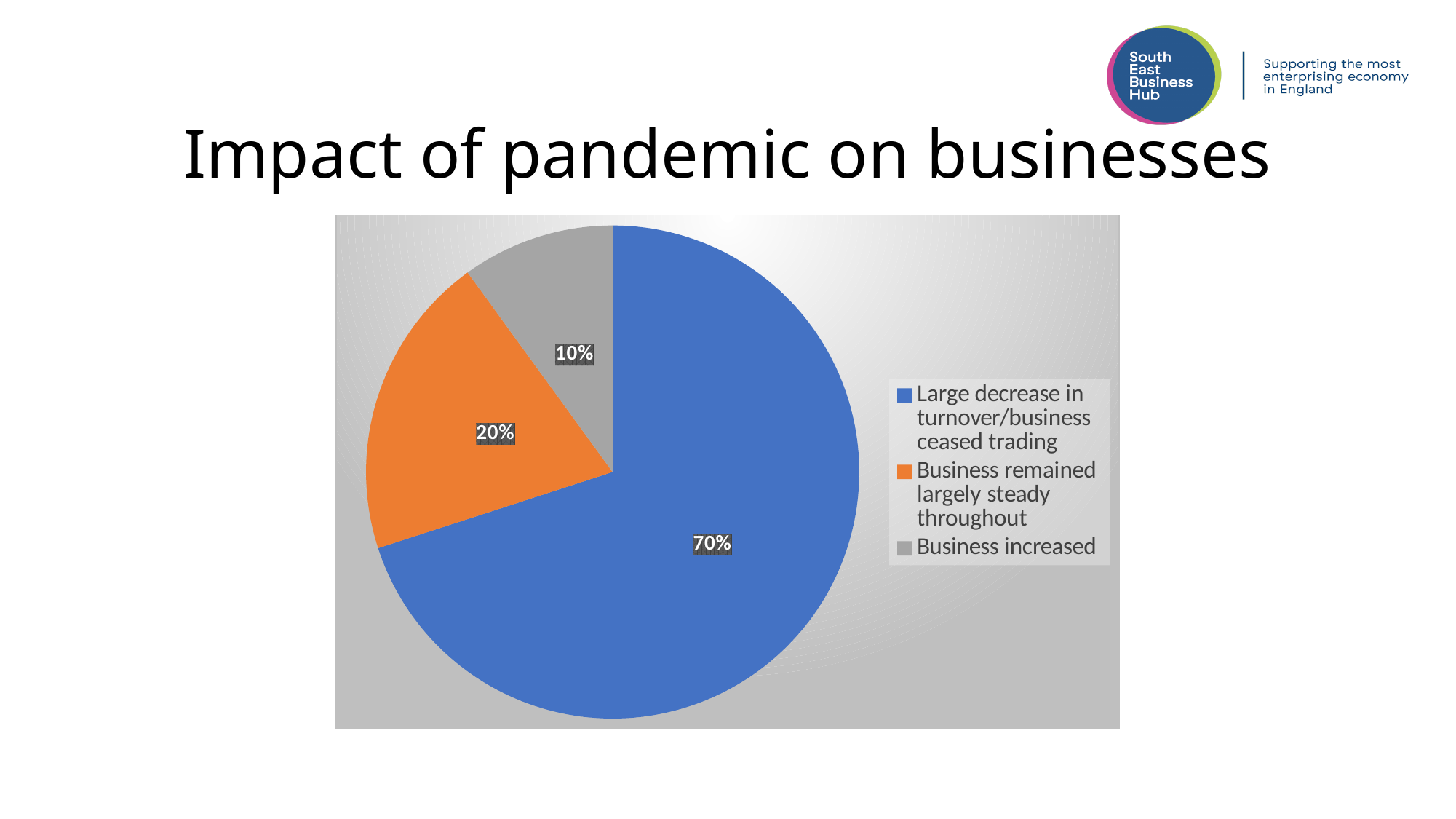
Which category has the smallest slice of the pie? Business increased What share of the pie is 'Large decrease in turnover/business ceased trading'? 70% Which category has the largest slice of the pie? Large decrease in turnover/business ceased trading What is the difference in percentage points between 'Large decrease in turnover/business ceased trading' and 'Business remained largely steady throughout'? 50 percentage points What is the difference in percentage points between 'Business remained largely steady throughout' and 'Business increased'? 10 percentage points What colour is the slice for 'Business increased'? grey How many slices does the pie chart have? 3 What kind of chart is shown on the slide? pie chart What share of the pie is 'Business increased'? 10% What is the title of the slide containing the pie chart? Impact of pandemic on businesses Which is larger: the slice for 'Business remained largely steady throughout' or the slice for 'Business increased'? Business remained largely steady throughout What share of the pie is 'Business remained largely steady throughout'? 20%